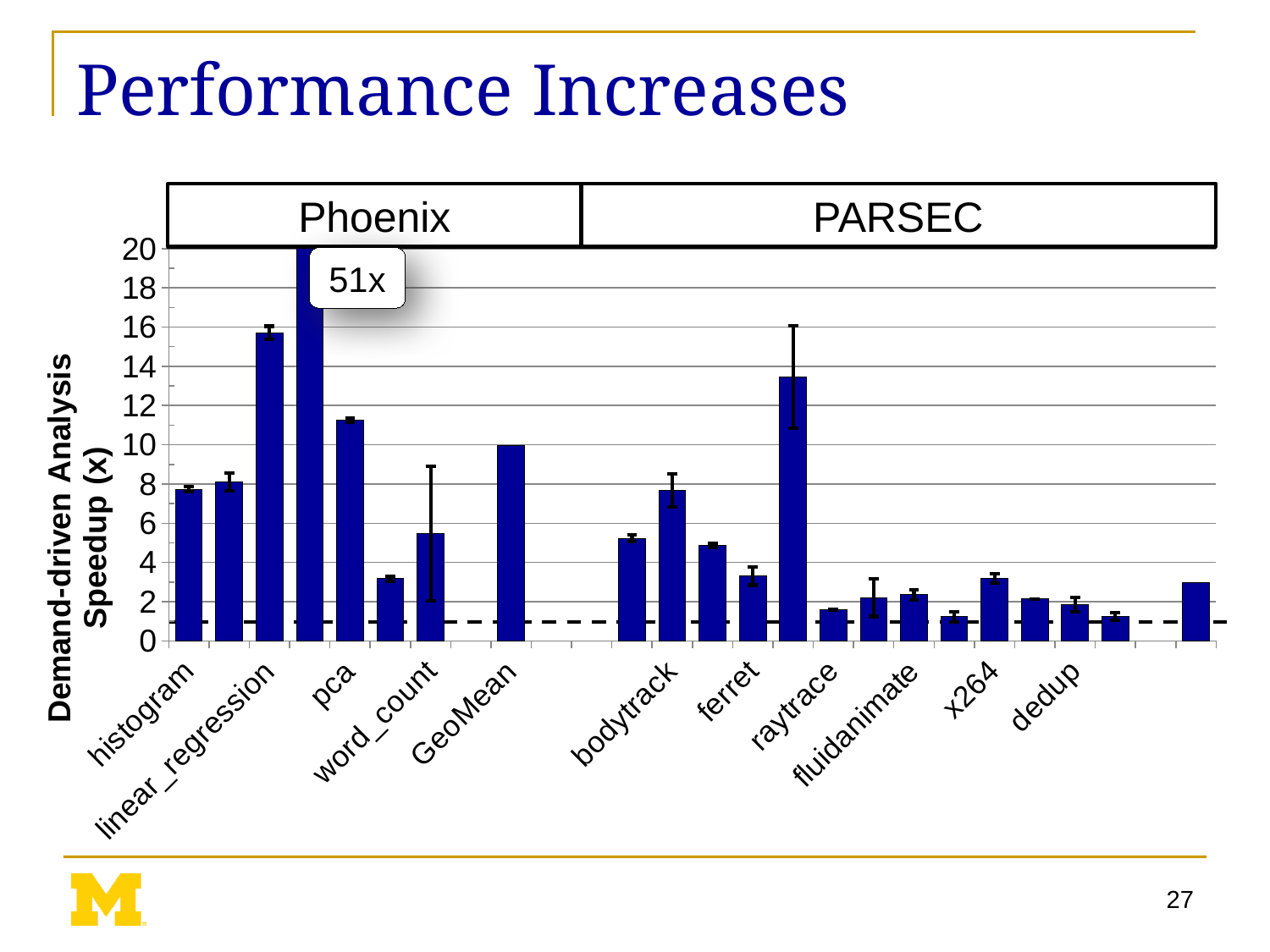
Is the value of the tallest bar in the chart greater or less than 20? greater Is the value for bodytrack greater or less than 4? greater What speedup value is annotated on the tallest bar in the chart? 51x What are the names of the two benchmark groups labelled above the chart? Phoenix and PARSEC Is the value for GeoMean greater or less than 8? greater At what y-axis value is the dashed horizontal line drawn across the chart? 1 Which benchmark group contains the tallest bar in the chart? Phoenix What kind of chart is shown on the slide? bar chart What is the title of the y axis of the chart? Demand-driven Analysis Speedup (x)